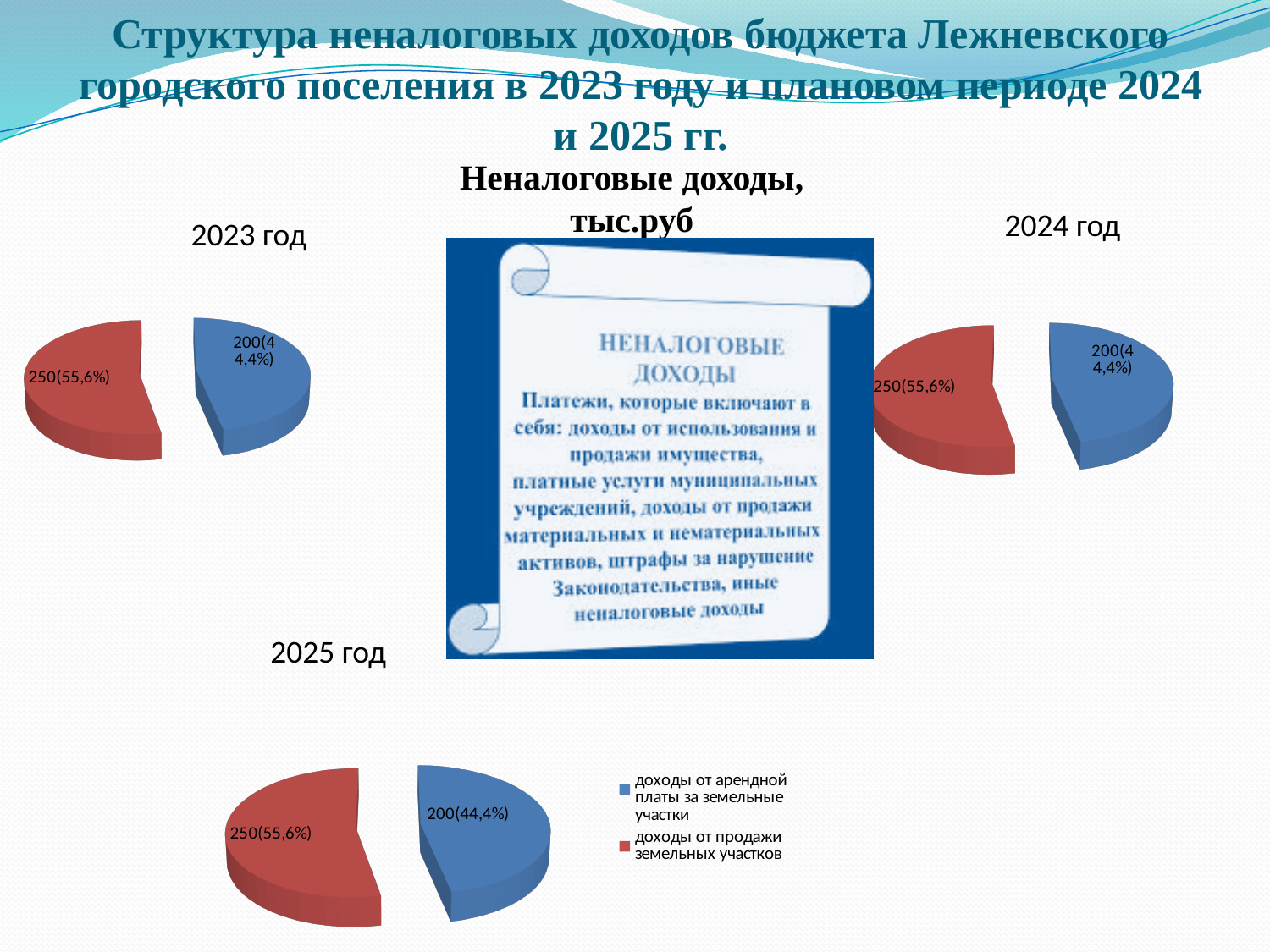
On the 2025 год pie chart, which slice is larger: доходы от арендной платы за земельные участки or доходы от продажи земельных участков? доходы от продажи земельных участков On the 2024 год pie chart, what share of the pie does the red slice (доходы от продажи земельных участков) represent? 55,6% On the 2023 год pie chart, what is the difference between the value for доходы от продажи земельных участков and the value for доходы от арендной платы за земельные участки? 50 How many entries does the legend next to the 2025 год chart list? 2 How many slices does the 2025 год pie chart have? 2 What kind of chart is used for the 2023 год data? Pie chart On the 2024 год pie chart, which slice is the smallest? доходы от арендной платы за земельные участки On the 2023 год pie chart, what value is shown for доходы от продажи земельных участков (the red slice)? 250 On the 2024 год pie chart, what is the total of the two slices? 450 According to the legend, which colour represents доходы от продажи земельных участков? Red On the 2025 год pie chart, what value is shown for the blue slice (доходы от арендной платы за земельные участки)? 200 On the 2025 год pie chart, what share of the pie does the доходы от арендной платы за земельные участки slice (blue) represent? 44,4%